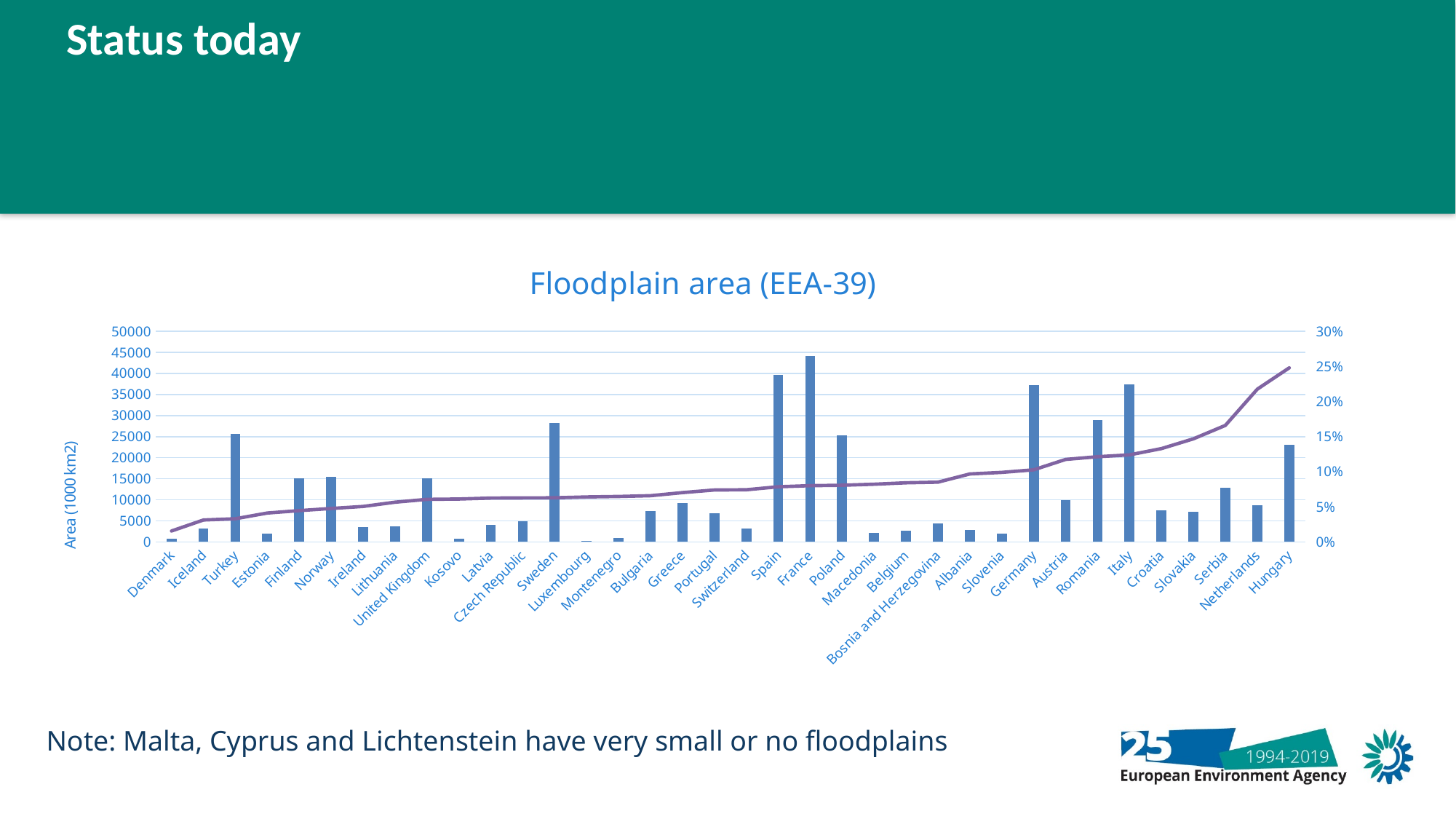
Which has the larger floodplain area bar, Spain or Sweden? Spain What kind of chart is used to show the floodplain area values? bar chart Is the floodplain area bar for Hungary greater or less than 20000? greater Is the floodplain area bar for Sweden greater or less than 25000? greater Which country has the lowest floodplain area bar? Luxembourg What is the title of the chart? Floodplain area (EEA-39) Which has the larger floodplain area bar, Italy or Romania? Italy Which country has the highest floodplain area bar? France Is the floodplain area bar for Denmark greater or less than 5000? less Does the purple line rise or fall from Denmark to Hungary along the x axis? rises How many countries are shown on the x axis of the chart? 36